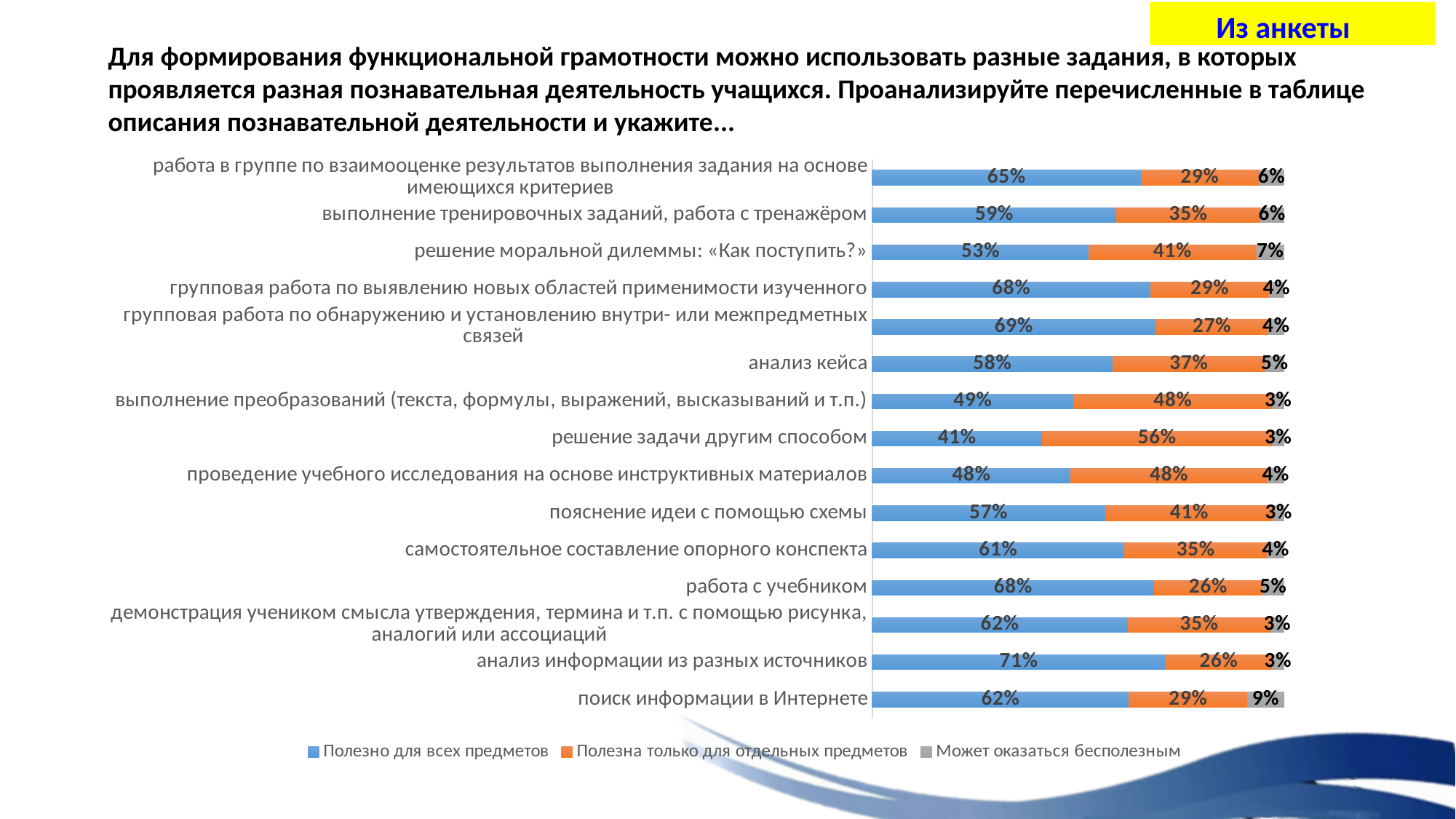
What is the value of «Может оказаться бесполезным» for «поиск информации в Интернете»? 9% What kind of chart is shown on the slide? stacked bar chart What is the value of «Полезна только для отдельных предметов» for «решение задачи другим способом»? 56% Which activity has the highest value for «Полезно для всех предметов»? анализ информации из разных источников How many series does the legend list? 3 Which is larger for «выполнение тренировочных заданий, работа с тренажёром»: the «Полезно для всех предметов» value or the «Полезна только для отдельных предметов» value? Полезно для всех предметов Which activity has the highest value for «Может оказаться бесполезным»? поиск информации в Интернете Which colour represents the series «Полезна только для отдельных предметов»? orange What is the difference between the «Полезно для всех предметов» values for «работа с учебником» and «решение моральной дилеммы: «Как поступить?»»? 15% Which activity has the lowest value for «Полезно для всех предметов»? решение задачи другим способом What percentage of respondents considered «анализ кейса» useful for all subjects (Полезно для всех предметов)? 58% How many activities (categories) are shown in the chart? 15